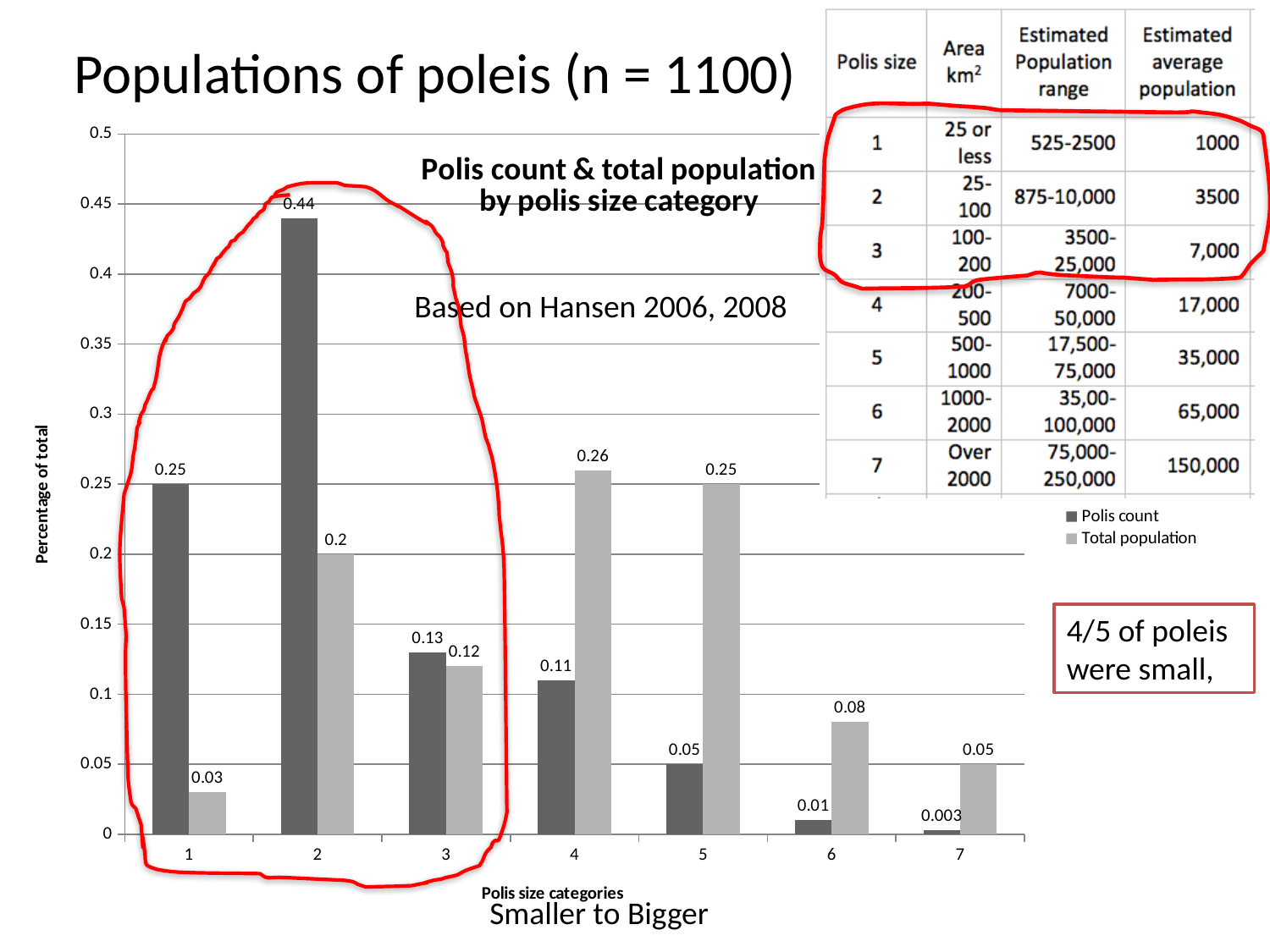
Which polis size category has the highest Polis count value? 2 What is the Polis count value for polis size category 2? 0.44 For polis size category 5, which is larger: Polis count or Total population? Total population What is the difference between the Polis count and Total population values for polis size category 2? 0.24 Is the Total population value for polis size category 6 greater or less than 0.1? less Which polis size category has the lowest Total population value? 1 How many polis size categories are shown on the x axis? 7 How many series does the legend list? 2 What is the Total population value for polis size category 4? 0.26 What is the Polis count value for polis size category 7? 0.003 What kind of chart is shown on the slide? bar chart What is the label of the y axis of the chart? Percentage of total